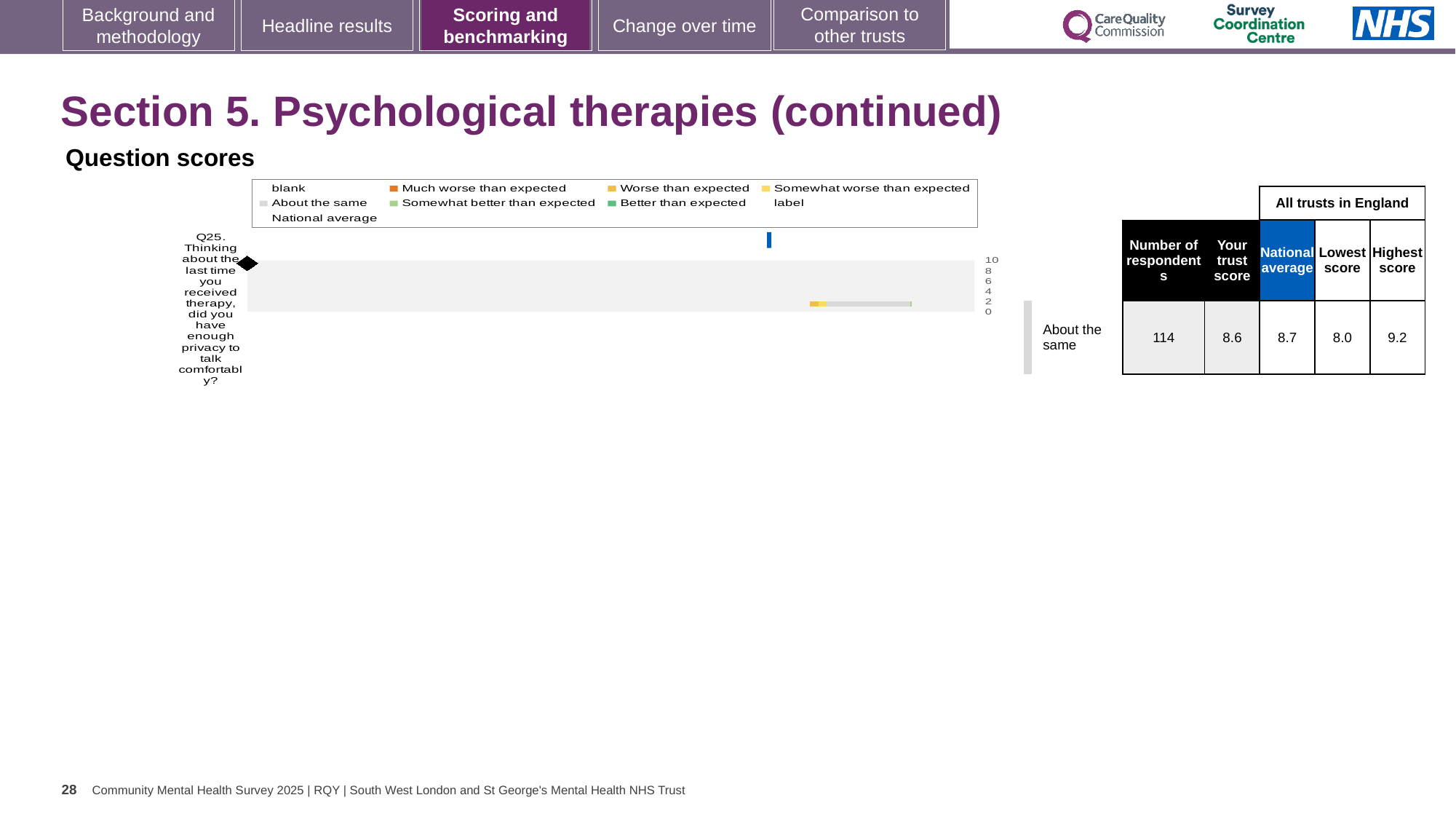
What is the highest value shown on the chart's axis? 10 What is the national average for Q25 shown in the table next to the chart? 8.7 What is the difference between the highest score and the lowest score for Q25 across all trusts in England? 1.2 How many respondents answered Q25? 114 What benchmark category is the trust's Q25 score placed in? About the same How many questions are plotted in the question scores chart? 1 What is the highest score among all trusts in England for Q25? 9.2 Which question is shown in the question scores chart? Q25. Thinking about the last time you received therapy, did you have enough privacy to talk comfortably? What is the lowest score among all trusts in England for Q25? 8.0 Which is larger for Q25, the trust score or the national average? national average What kind of chart is used to show the Q25 question score? bar chart What is the trust's score for Q25 shown in the table next to the chart? 8.6